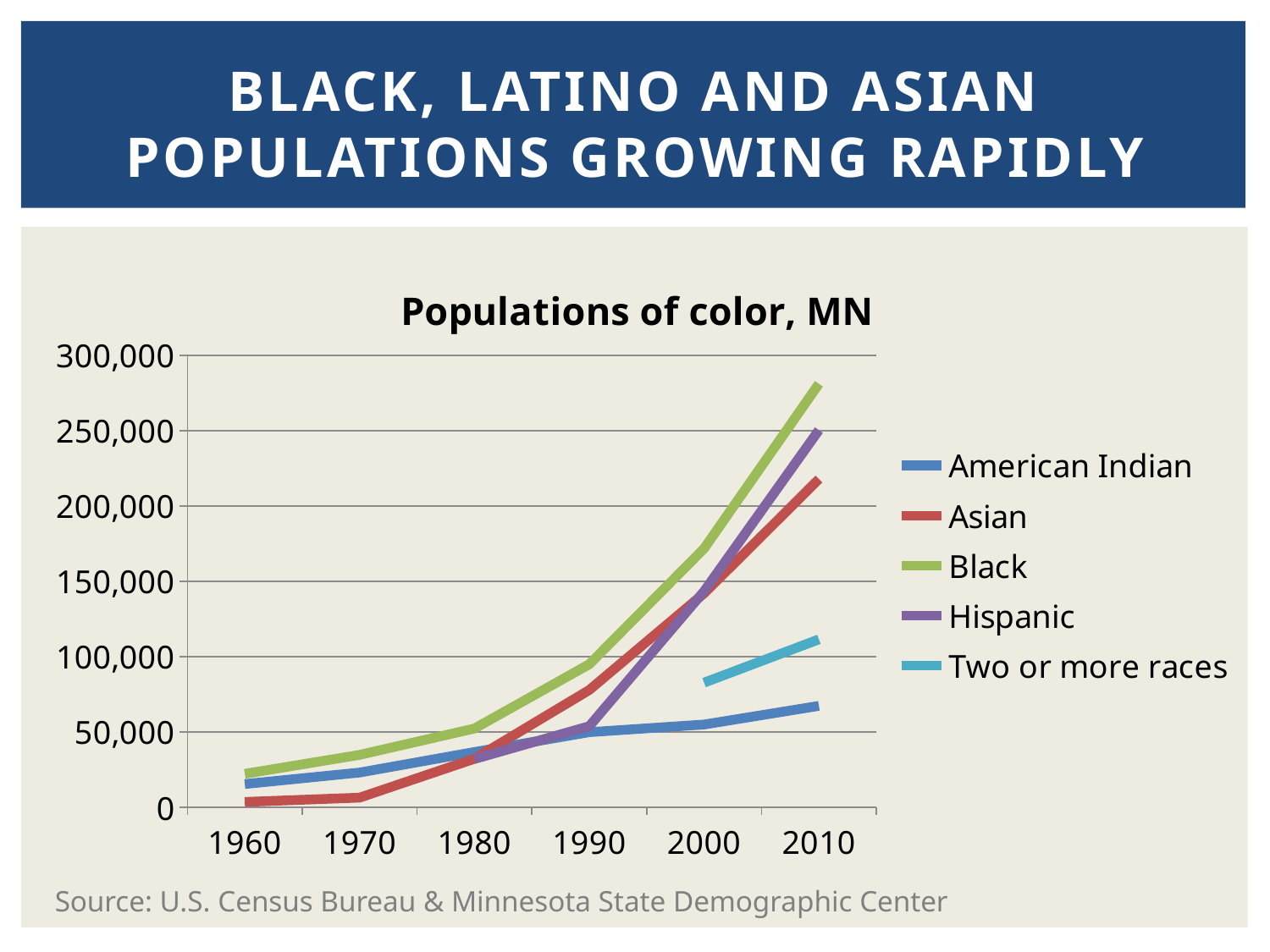
What is the title of the chart? Populations of color, MN Is the value for American Indian in 2010 greater or less than 100,000? less How many years are marked along the x axis? 6 Does the Black population rise or fall from 1960 to 2010? Rises Is the value for Black in 2010 greater or less than 250,000? greater Is the value for Two or more races in 2010 greater or less than 100,000? greater In 2010, which is larger: the Hispanic population or the Asian population? Hispanic What kind of chart is shown on the slide? Line chart Which population group has the highest value in 2010? Black How many series does the legend list? 5 Which population group has the lowest value in 2010? American Indian